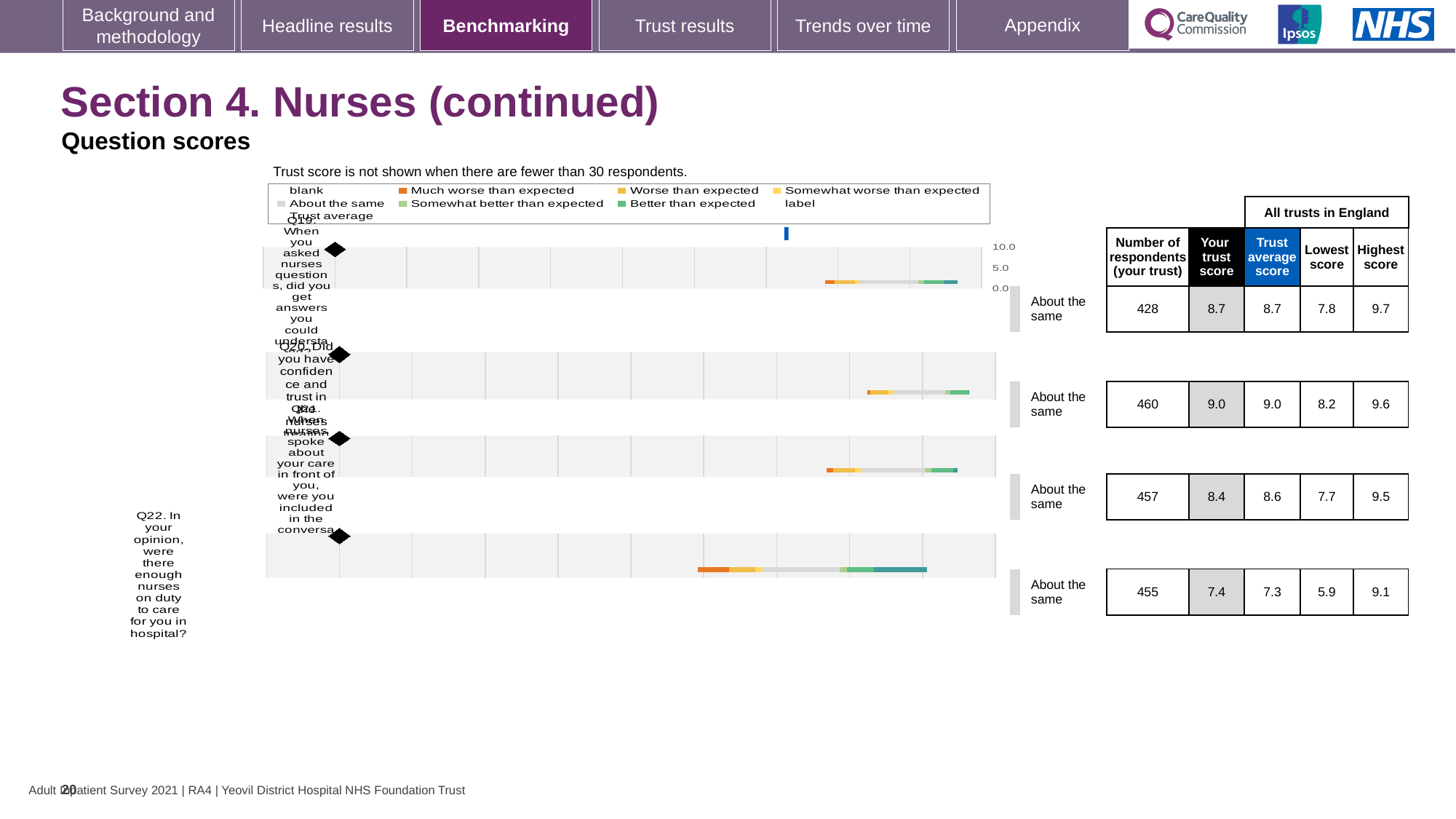
What is the difference between the trust scores for Q19 and Q22? 1.3 What is the trust score for Q19 (When you asked nurses questions, did you get answers you could understand)? 8.7 What kind of chart is used to show the question scores on this slide? bar chart What benchmark category is shown for all four questions on this slide? About the same How many questions (categories) are plotted in the chart? 4 What is the trust average score for Q21? 8.6 What is the trust score for Q22 (were there enough nurses on duty to care for you in hospital)? 7.4 What is the lowest score across all trusts in England for Q22? 5.9 For Q21, which is larger: the trust score or the trust average score? Trust average score What is the maximum value shown on the chart's score axis? 10.0 Which question has the lowest trust score? Q22 Which question has the highest trust score? Q20